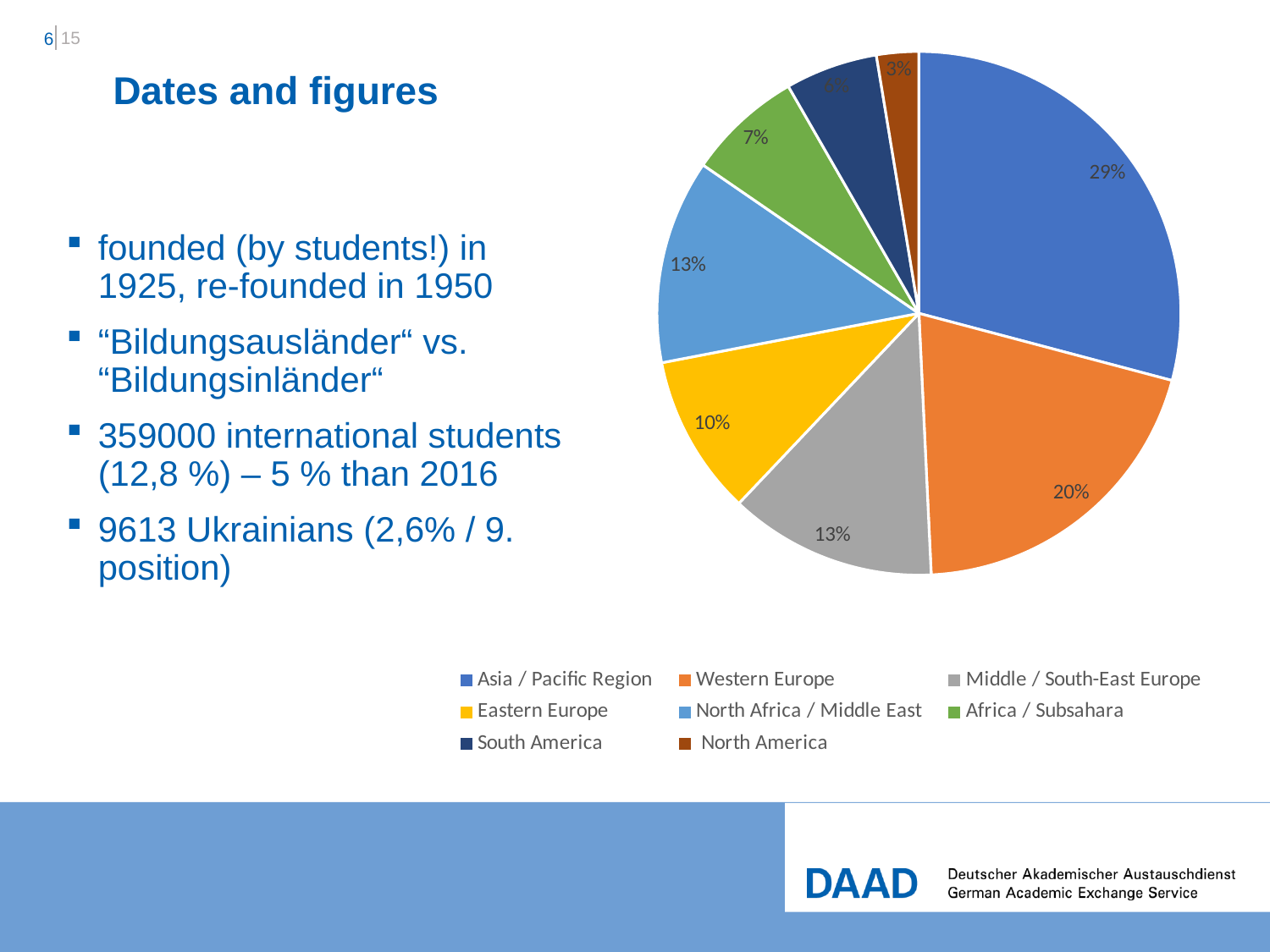
By how many percentage points does Asia / Pacific Region exceed Western Europe? 9 percentage points What type of chart is shown on the slide? Pie chart Which region has the smallest slice of the pie? North America What percentage is shown for Western Europe? 20% What percentage is shown for Middle / South-East Europe? 13% What percentage is shown for Africa / Subsahara? 7% What percentage is shown for North America? 3% Which region has the largest slice of the pie? Asia / Pacific Region What share of the pie does Asia / Pacific Region hold? 29% Which is larger, the slice for Western Europe or the slice for Eastern Europe? Western Europe How many regions are listed in the legend? 8 What percentage is shown for Eastern Europe? 10%